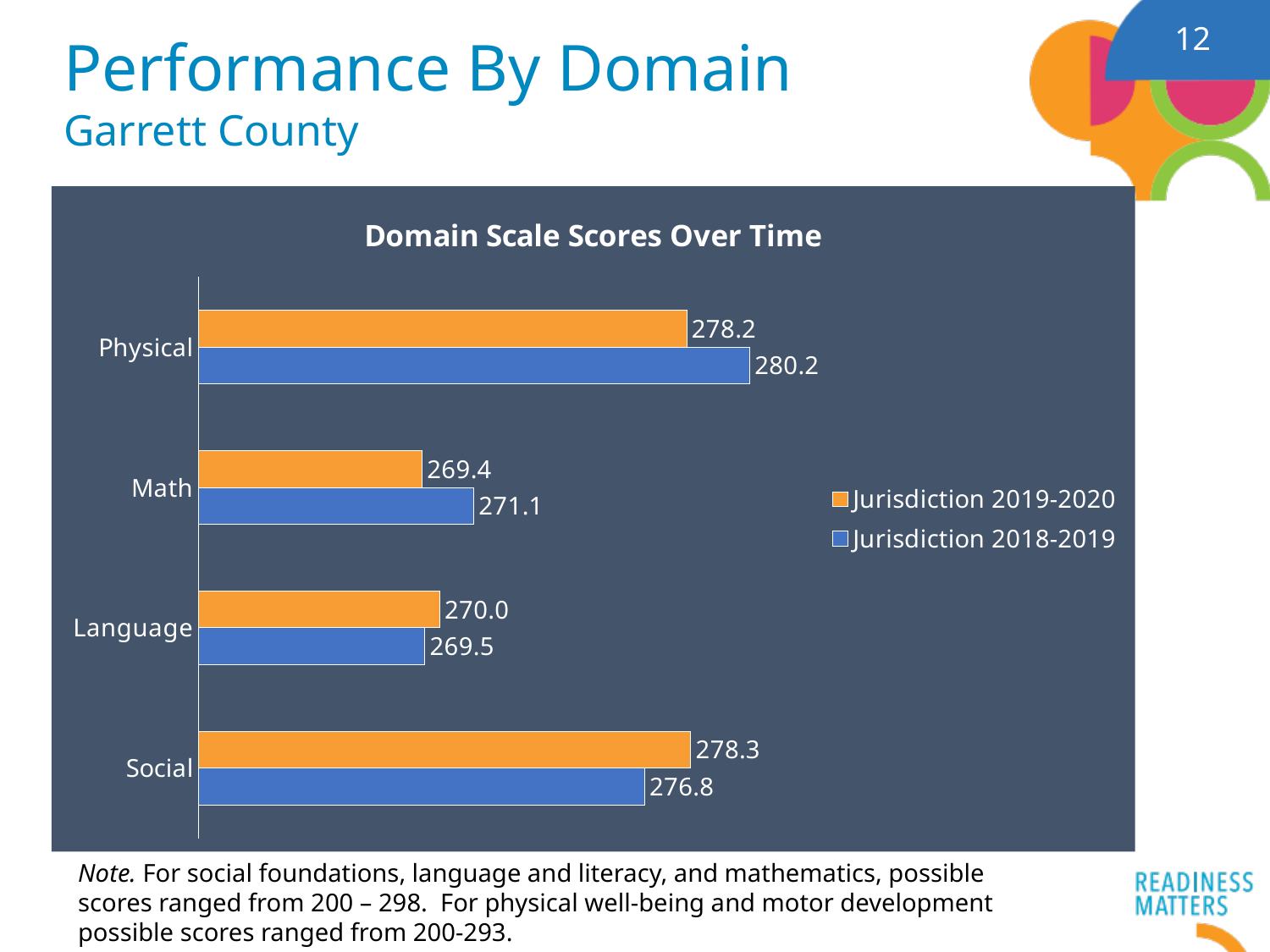
What is the Jurisdiction 2018-2019 score for Math? 271.1 What is the difference between the Jurisdiction 2018-2019 and Jurisdiction 2019-2020 scores for Physical? 2.0 Which domain has the highest Jurisdiction 2018-2019 score? Physical What is the Jurisdiction 2019-2020 score for Physical? 278.2 How many series does the legend list? 2 For Physical, which is larger: the Jurisdiction 2019-2020 score or the Jurisdiction 2018-2019 score? Jurisdiction 2018-2019 What is the difference between the Jurisdiction 2019-2020 and Jurisdiction 2018-2019 scores for Social? 1.5 How many domains are shown in the chart? 4 Which domain has the lowest Jurisdiction 2018-2019 score? Language What type of chart is shown on the slide? Bar chart What is the Jurisdiction 2018-2019 score for Social? 276.8 What is the Jurisdiction 2019-2020 score for Language? 270.0